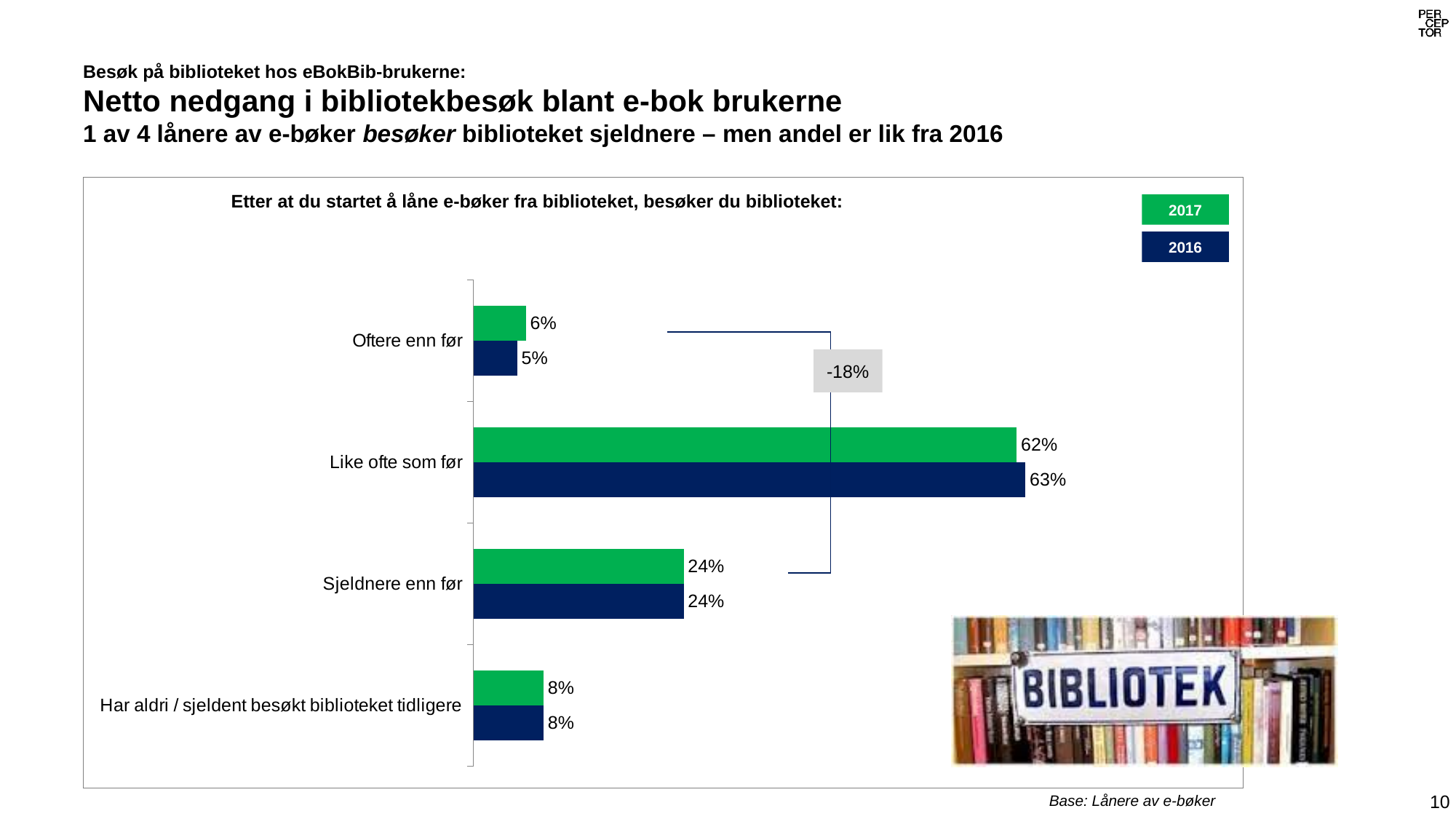
What kind of chart is shown on the slide? Bar chart Which is larger for "Oftere enn før": the 2017 value or the 2016 value? 2017 What is the 2016 value for "Oftere enn før"? 5% Which colour represents the 2016 series in the chart? Dark blue How many series does the legend list? 2 What is the 2016 value for "Har aldri / sjeldent besøkt biblioteket tidligere"? 8% Which category has the lowest 2016 value? Oftere enn før What is the 2017 value for "Like ofte som før"? 62% How many categories are shown in the chart? 4 What is the 2017 value for "Sjeldnere enn før"? 24% What is the difference between the 2017 and 2016 values for "Like ofte som før"? 1% Which category has the highest 2017 value? Like ofte som før